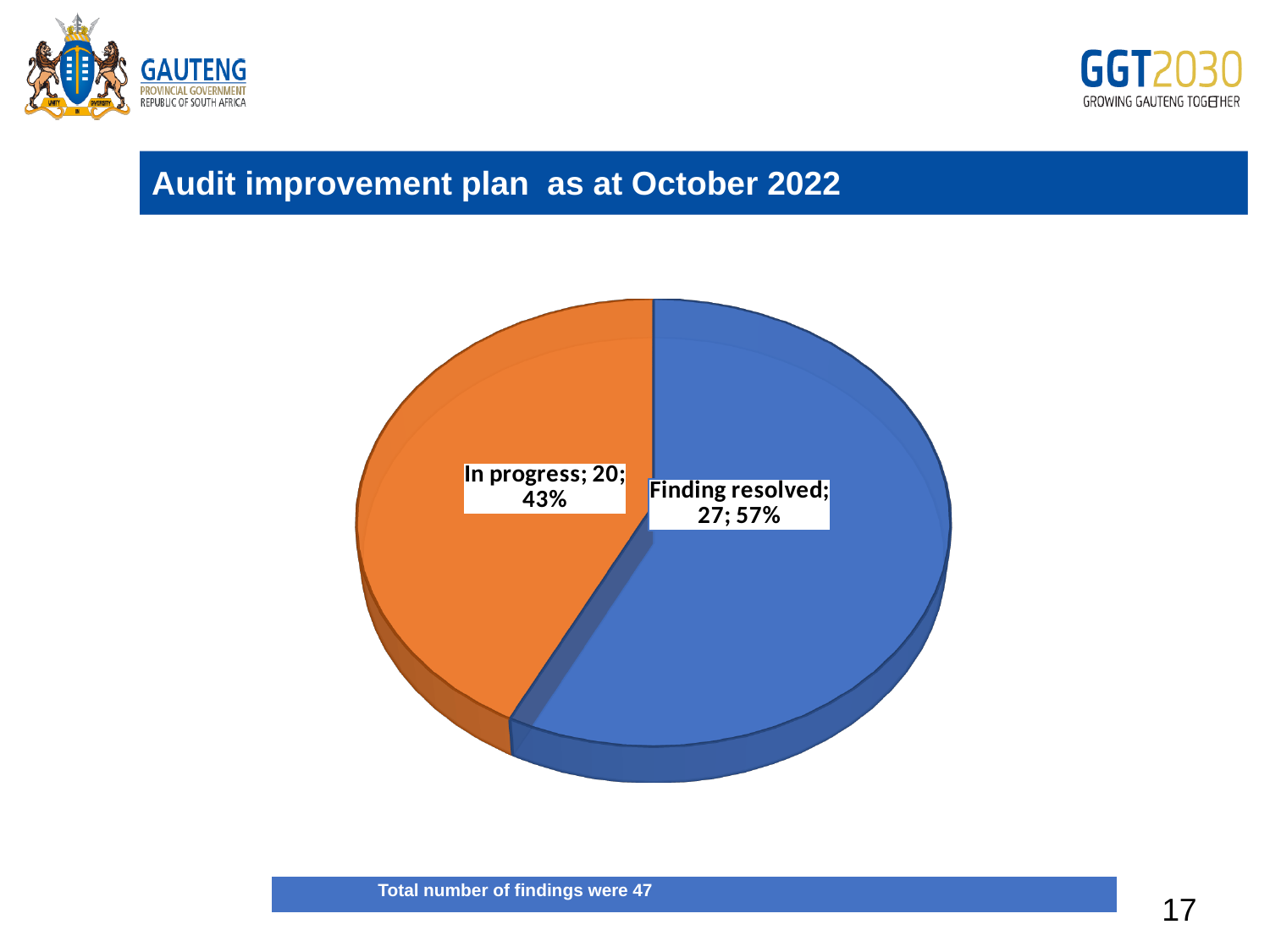
What is the total number of findings across both slices? 47 How many categories does the pie chart show? 2 Which category has the larger slice of the pie? Finding resolved What is the difference between the number of findings resolved and the number in progress? 7 What kind of chart is shown on the slide? Pie chart What share of the pie does 'Finding resolved' represent? 57% Which category has the smaller slice of the pie? In progress How many findings are shown as 'In progress'? 20 What share of the pie does 'In progress' represent? 43% How many findings are shown as 'Finding resolved'? 27 What colour is the 'In progress' slice? Orange Is the number of findings resolved larger or smaller than the number in progress? Larger